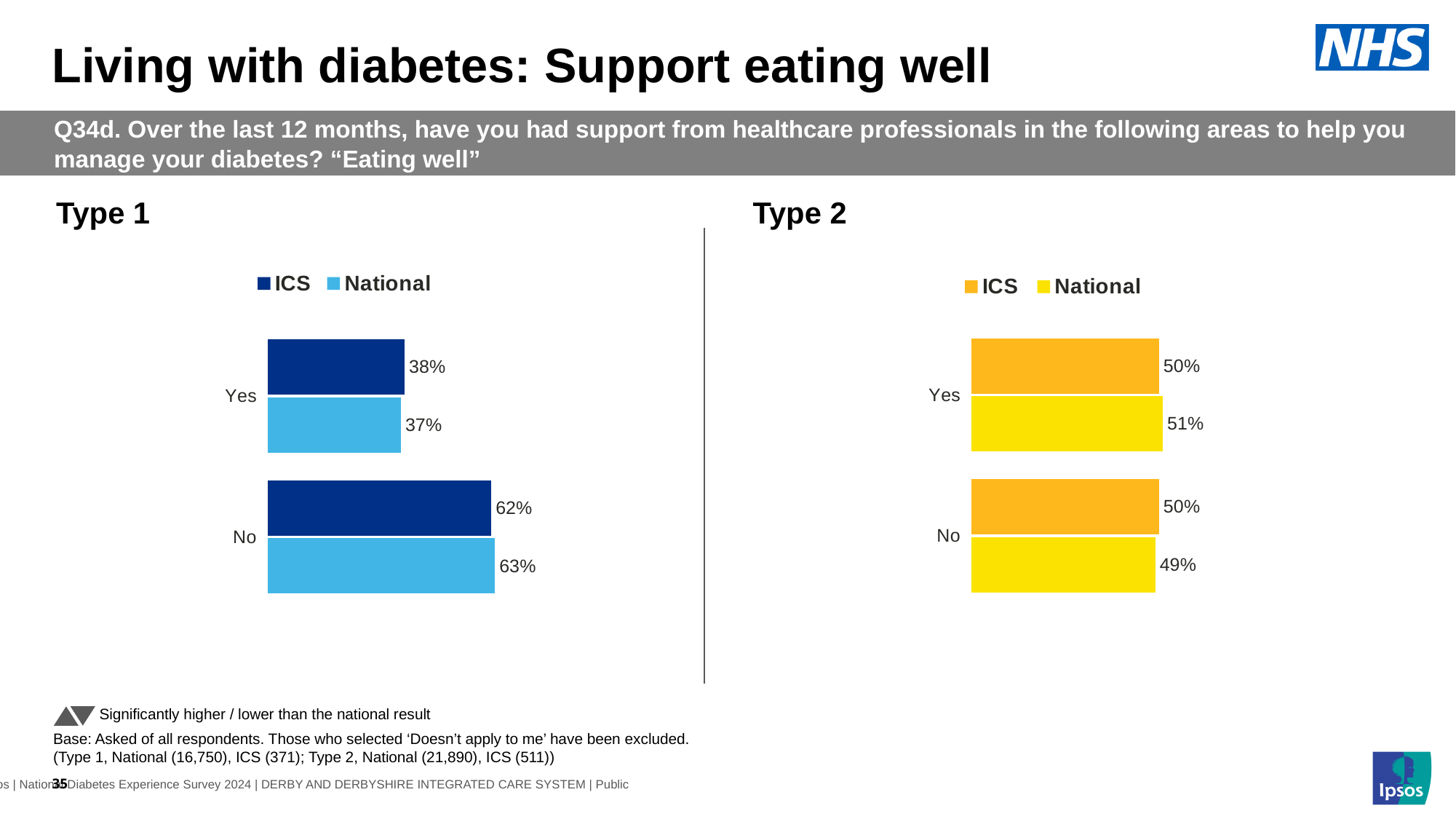
How many categories are shown in the Type 1 chart? 2 In the Type 1 chart, what is the National value for No? 63% In the Type 2 chart, which category has the lowest National value? No In the Type 2 chart, what is the difference between the ICS value for Yes and the ICS value for No? 0% In the Type 1 chart, what is the ICS value for Yes? 38% In the Type 2 chart, what is the National value for Yes? 51% In the Type 1 chart, what is the difference between the ICS and National values for No? 1% In the Type 1 chart, which is larger: the ICS value for Yes or the ICS value for No? No In the Type 1 chart, which category has the highest National value? No How many series does the legend of the Type 2 chart list? 2 In the Type 2 chart, what is the ICS value for No? 50% What kind of chart is the Type 2 chart? Bar chart